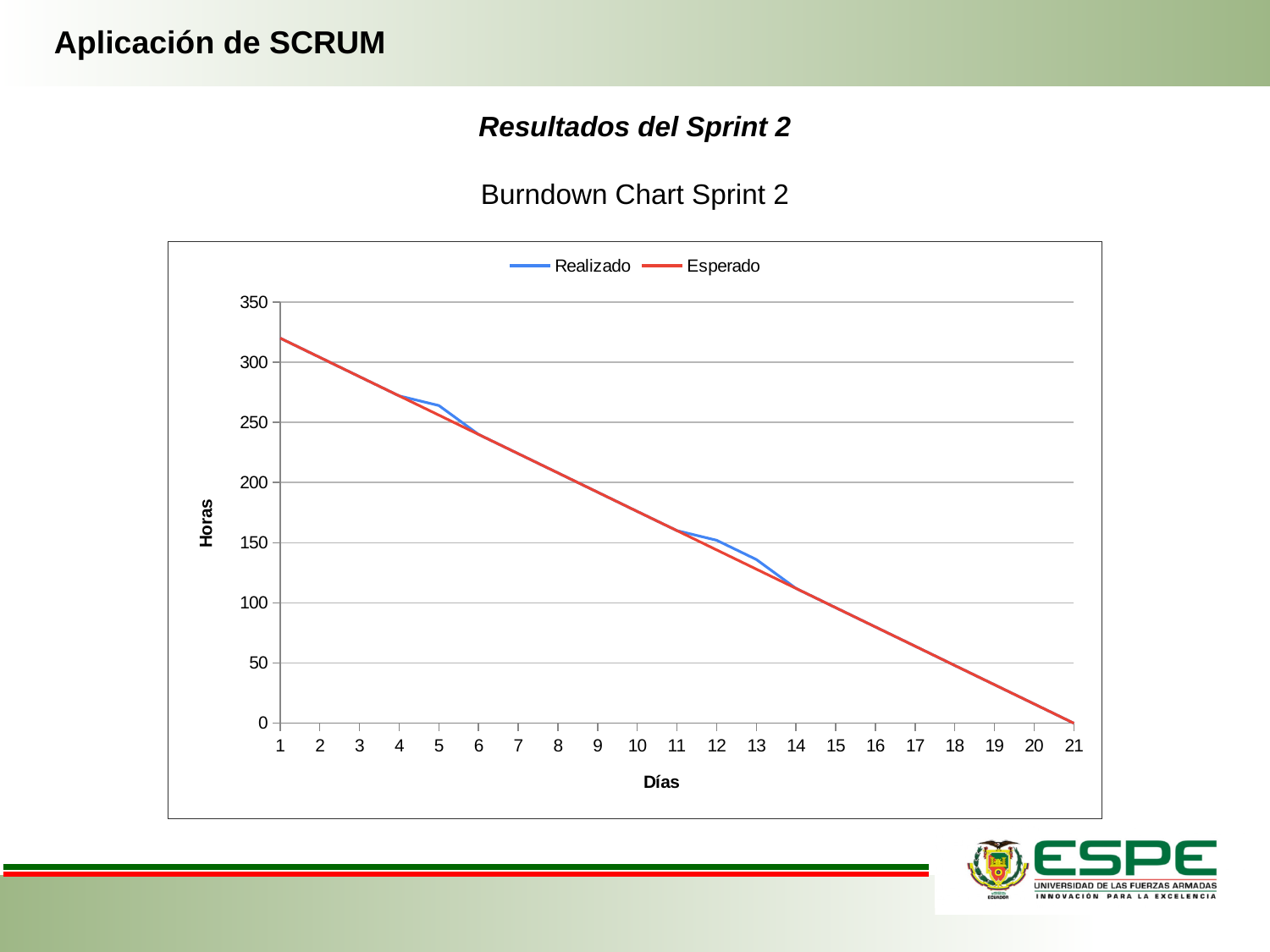
What is the label of the vertical axis? Horas Is the value of the Realizado series on day 5 greater or less than 250? greater What is the value of the Esperado series on day 21? 0 How many series does the legend list? 2 Is the value of the Esperado series on day 1 greater or less than 300? greater Is the value of the Realizado series on day 14 greater or less than 150? less Do the values of the Esperado series rise or fall as the days increase? fall What kind of chart is shown on the slide? line chart What is the title of the chart? Burndown Chart Sprint 2 How many days are shown along the x axis? 21